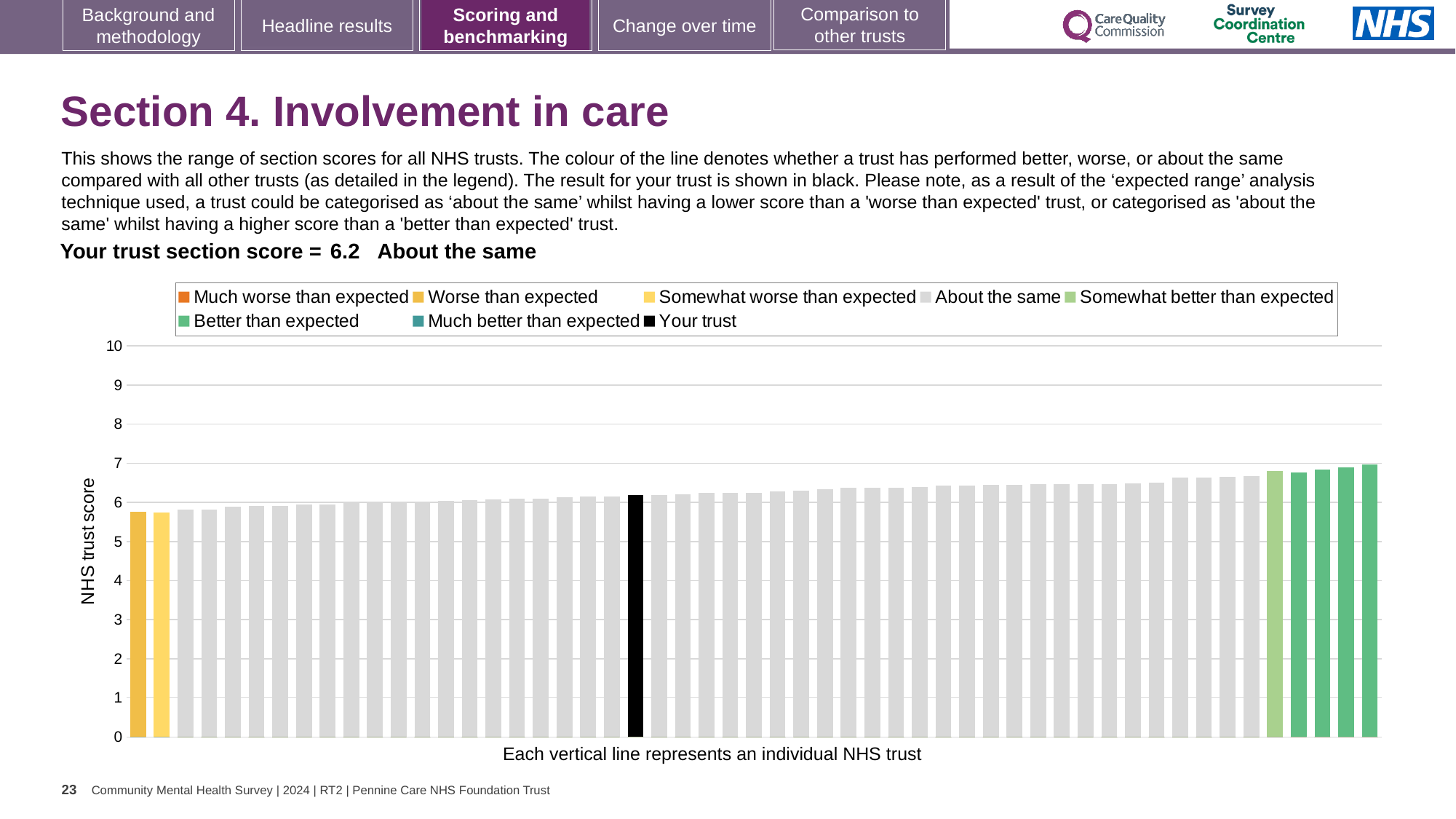
Which performance category is your trust's section score placed in? About the same Is the value for your trust greater or less than 5? greater What is the section score for your trust shown on the slide? 6.2 What kind of chart is shown on the slide? bar chart Is the value of the lowest bar greater or less than 5? greater What colour is the bar representing your trust? black How many bars are coloured as 'Better than expected' (dark green)? 4 How many bars are coloured as 'Worse than expected' (yellow)? 1 Do the bar values rise or fall from left to right along the x axis? rise Is the value of the highest bar greater or less than 8? less How many entries does the chart legend list? 8